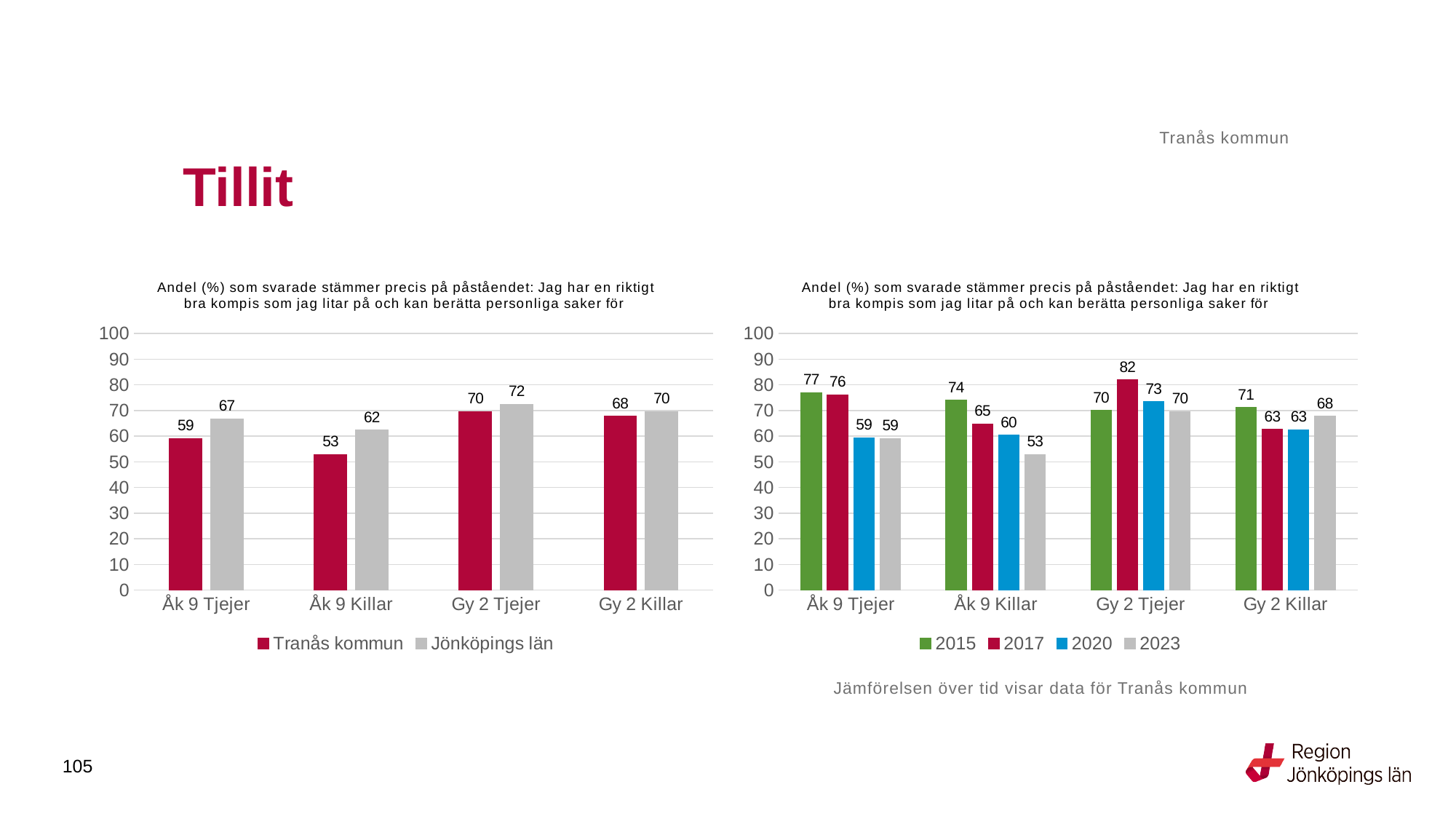
In the left chart, what is the value for Jönköpings län for Gy 2 Tjejer? 72 In the right chart, what is the value for 2023 for Åk 9 Killar? 53 In the left chart, what is the value for Tranås kommun for Åk 9 Killar? 53 What kind of chart is the left chart? Bar chart In the left chart, what is the difference between Jönköpings län and Tranås kommun for Åk 9 Killar? 9 In the right chart, which year has the highest value for Åk 9 Tjejer? 2015 In the right chart, what is the difference between the 2015 and 2023 values for Åk 9 Killar? 21 In the left chart, how many series does the legend list? 2 In the right chart, what is the value for 2017 for Gy 2 Tjejer? 82 In the right chart, how many series does the legend list? 4 In the left chart, which category has the lowest value for Tranås kommun? Åk 9 Killar In the right chart, is the 2020 value for Gy 2 Killar larger or smaller than the 2023 value for Gy 2 Killar? Smaller